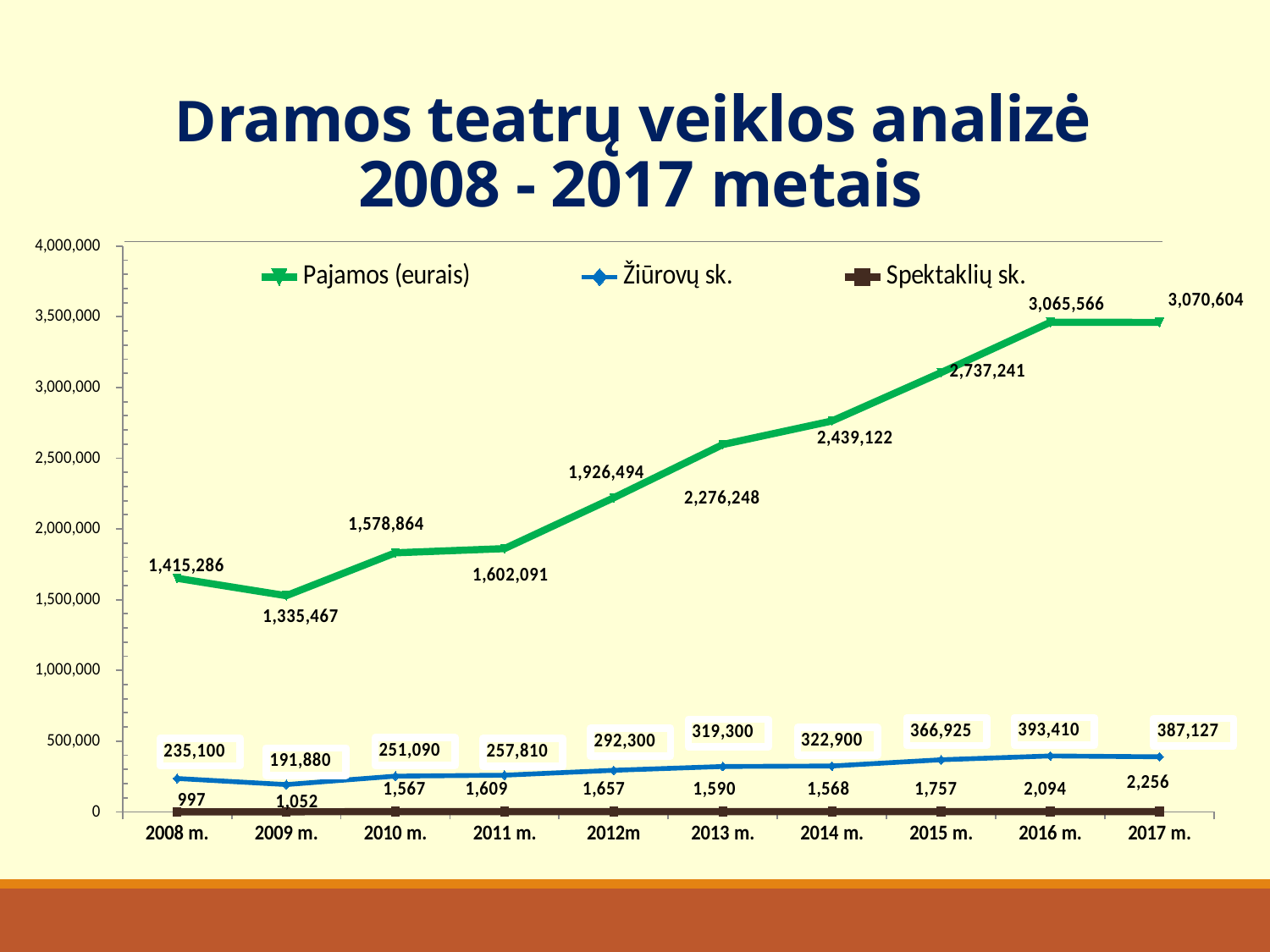
What is the difference between Žiūrovų sk. in 2009 m. and 2008 m.? 43,220 In which year is Žiūrovų sk. highest? 2016 m. In which year is Spektaklių sk. highest? 2017 m. Which is larger, Žiūrovų sk. in 2016 m. or in 2017 m.? 2016 m. What is the value of Žiūrovų sk. for 2012m? 292,300 What is the difference between Spektaklių sk. in 2017 m. and 2016 m.? 162 What is the value of Spektaklių sk. for 2008 m.? 997 How many years are shown on the x axis? 10 How many series does the legend list? 3 In which year is Pajamos (eurais) lowest? 2009 m. What kind of chart is shown on the slide? Line chart What is the value of Pajamos (eurais) for 2017 m.? 3,070,604